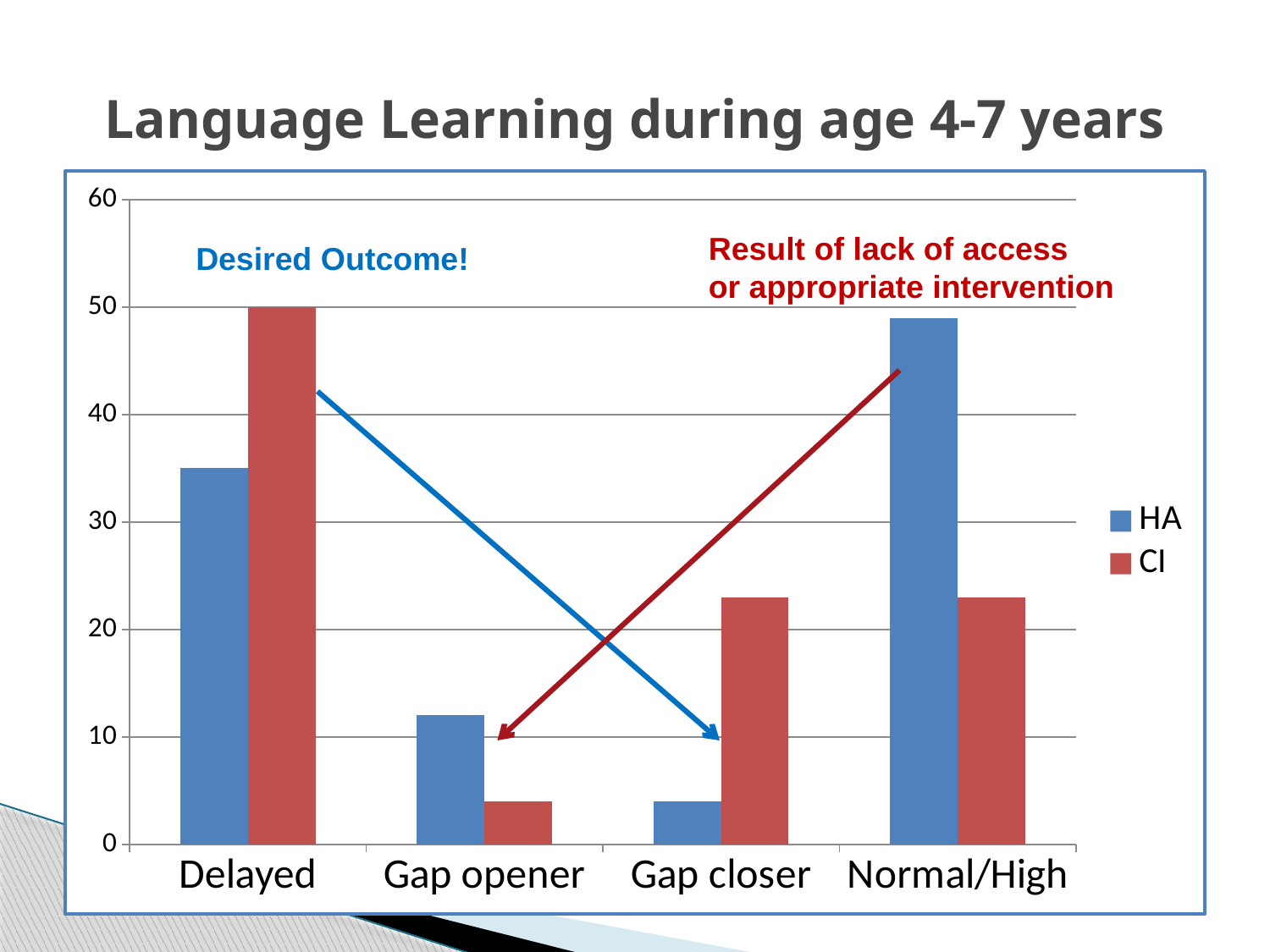
How many series does the legend list? 2 For the Gap closer category, which series has the larger value, HA or CI? CI Is the HA value for Gap opener greater or less than 20? less Which category has the lowest CI value? Gap opener What type of chart is shown on the slide? Bar chart How many categories are shown on the x axis? 4 For the Normal/High category, which series has the larger value, HA or CI? HA Is the HA value for Delayed greater or less than 30? greater Which category has the highest HA value? Normal/High What is the CI value for the Delayed category? 50 What is the title of the chart? Language Learning during age 4-7 years Which category has the highest CI value? Delayed